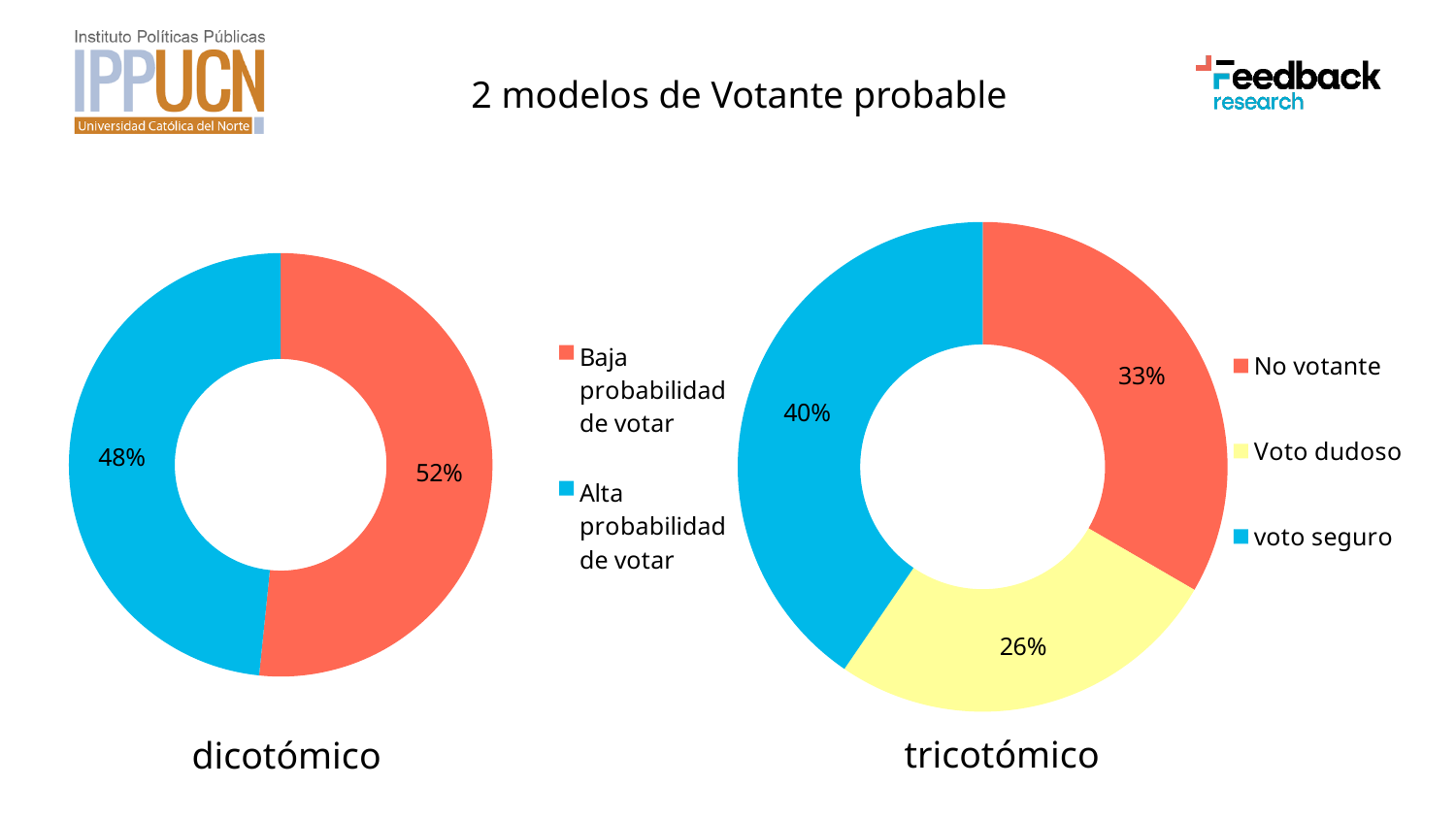
In the 'tricotómico' chart, what percentage is shown for 'Voto dudoso'? 26% How many entries does the legend of the 'dicotómico' chart list? 2 In the 'tricotómico' chart, which is larger: 'No votante' or 'Voto dudoso'? No votante What type of chart is the 'tricotómico' chart? Doughnut chart In the 'tricotómico' chart, what percentage is shown for 'voto seguro'? 40% In the 'dicotómico' chart, what percentage is shown for 'Baja probabilidad de votar'? 52% How many categories does the 'tricotómico' chart show? 3 In the 'tricotómico' chart, which category has the smallest share? Voto dudoso In the 'tricotómico' chart, what colour represents 'Voto dudoso'? Yellow In the 'dicotómico' chart, what percentage is shown for 'Alta probabilidad de votar'? 48% In the 'tricotómico' chart, which category has the largest share? voto seguro In the 'dicotómico' chart, what is the difference in percentage points between 'Baja probabilidad de votar' and 'Alta probabilidad de votar'? 4